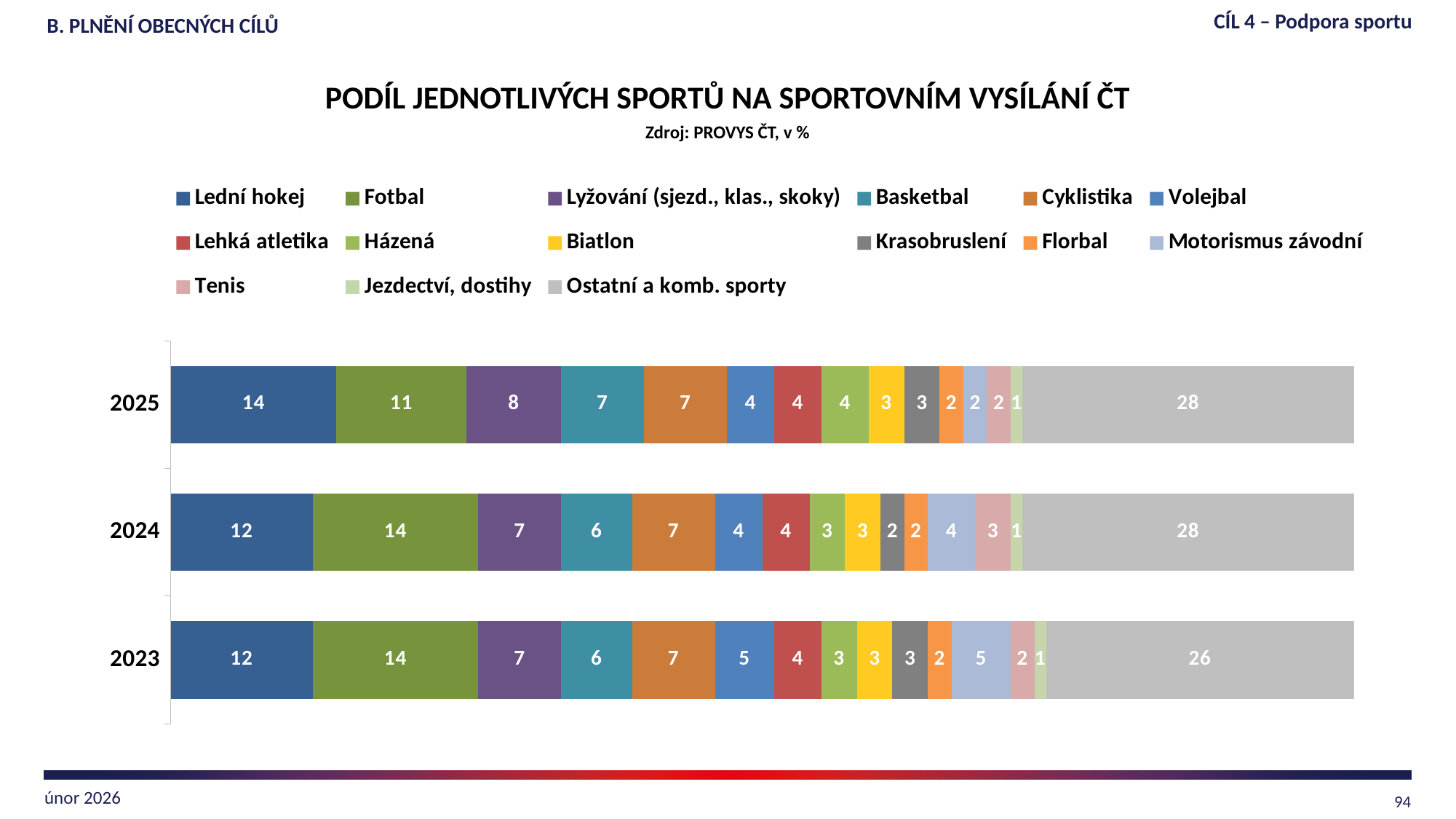
What is the value for Lyžování (sjezd., klas., skoky) in 2025? 8 What is the value for Lední hokej in 2025? 14 What is the value for Fotbal in 2024? 14 Which is larger in 2023: Volejbal or Lehká atletika? Volejbal Which sport has the largest share in 2025, excluding Ostatní a komb. sporty? Lední hokej How many series does the legend list? 15 Did the value for Fotbal rise or fall from 2023 to 2025? fall What kind of chart is shown on the slide? stacked bar chart What is the value for Ostatní a komb. sporty in 2023? 26 How many years (bars) are shown in the chart? 3 What is the source stated under the chart title? PROVYS ČT, v % What is the difference between the Lední hokej value in 2025 and in 2024? 2